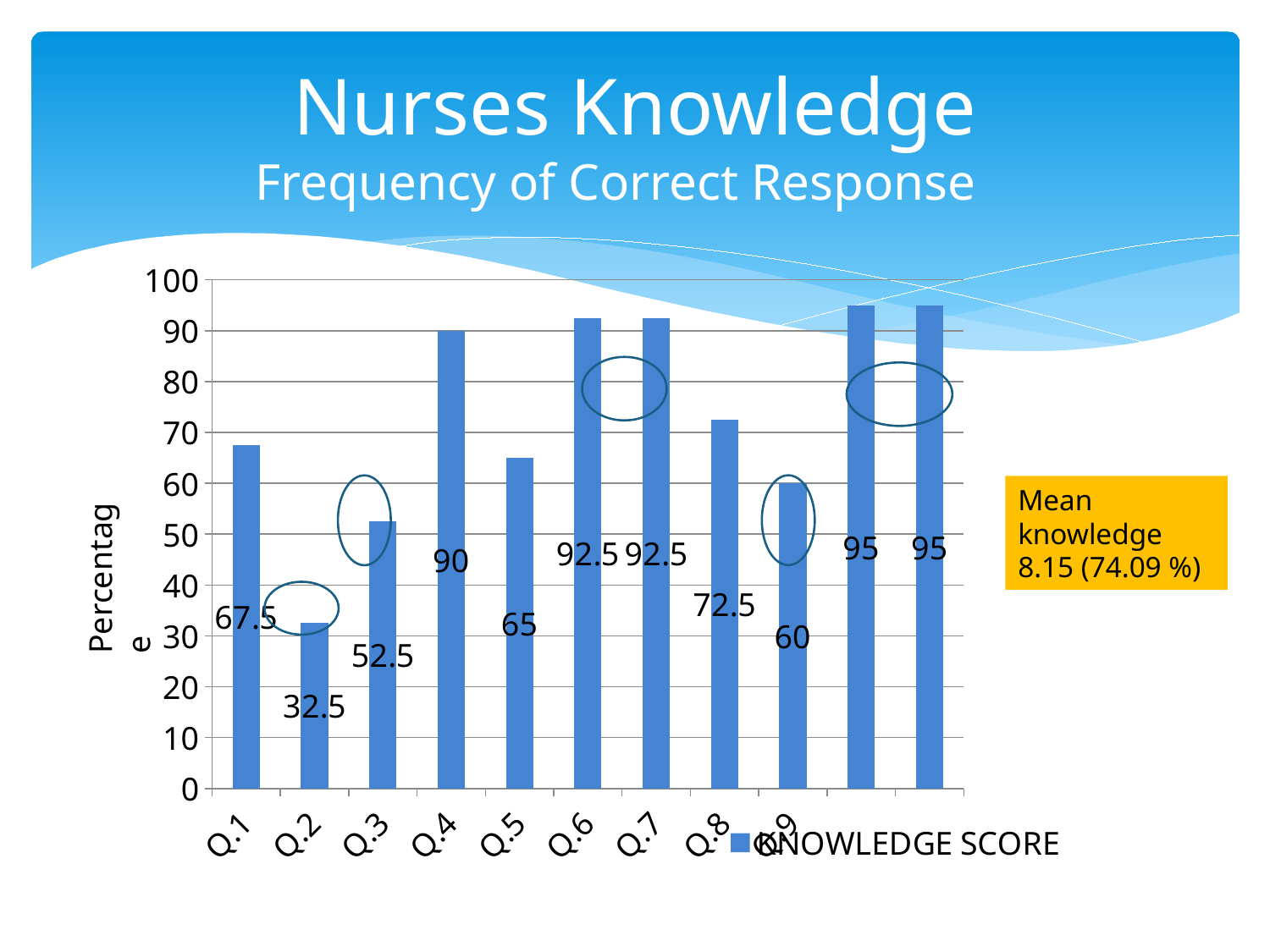
What is the value for Q.4? 90 How many bars are plotted on the chart? 11 Is the value for Q.6 greater or less than 90? greater What is the value for Q.8? 72.5 Which is larger, the value for Q.3 or the value for Q.5? Q.5 What kind of chart is shown on the slide? bar chart What is the value for Q.1? 67.5 How many series does the legend list? 1 What is the highest value shown on the chart? 95 What is the value for Q.9? 60 What is the difference between the values for Q.4 and Q.2? 57.5 Which question has the lowest percentage of correct responses? Q.2